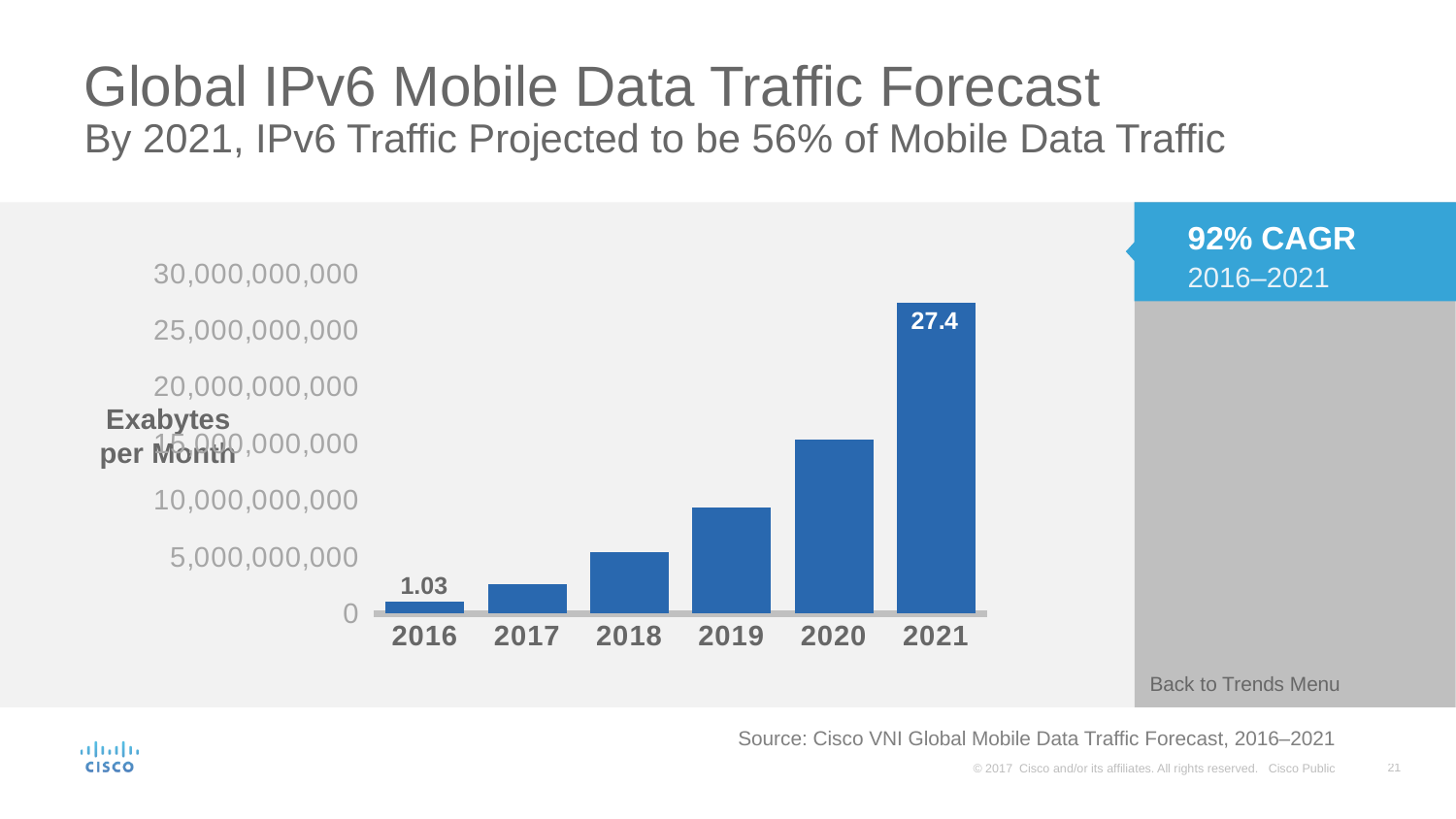
Which year has the highest bar? 2021 What is the data label shown for 2021? 27.4 Do the values rise or fall from 2016 to 2021? rise Which year has the lowest bar? 2016 How many years are shown on the x axis? 6 Is the value for 2020 greater or less than 10,000,000,000? greater What type of chart is shown on the slide? bar chart What is the difference between the labelled values for 2021 and 2016? 26.37 What CAGR for 2016–2021 is stated on the slide? 92% CAGR Which is larger, the value for 2019 or the value for 2020? 2020 Is the value for 2018 greater or less than 10,000,000,000? less What is the data label shown for 2016? 1.03